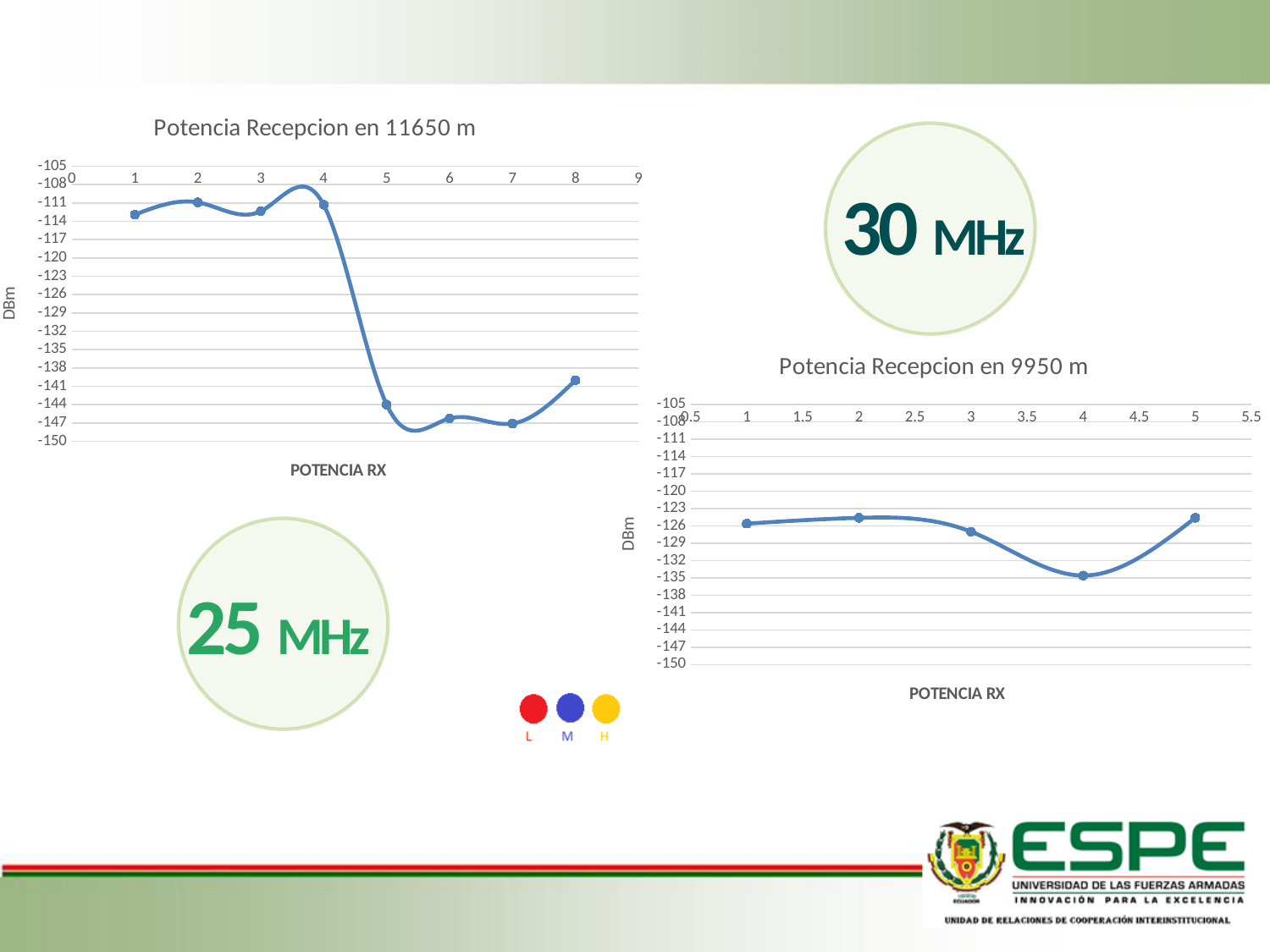
What kind of chart is 'Potencia Recepcion en 9950 m'? line chart In the 'Potencia Recepcion en 11650 m' chart, which is larger, the value at x = 2 or the value at x = 6? x = 2 What kind of chart is 'Potencia Recepcion en 11650 m'? line chart How many data points are plotted in the 'Potencia Recepcion en 11650 m' chart? 8 What is the y-axis label of the 'Potencia Recepcion en 11650 m' chart? DBm What series name is shown in the legend of the 'Potencia Recepcion en 9950 m' chart? POTENCIA RX In the 'Potencia Recepcion en 9950 m' chart, is the value at x = 4 greater or less than -132? less In the 'Potencia Recepcion en 11650 m' chart, is the value at x = 5 greater or less than -120? less In the 'Potencia Recepcion en 11650 m' chart, is the value at x = 1 greater or less than -120? greater In the 'Potencia Recepcion en 11650 m' chart, does the value rise or fall between x = 4 and x = 5? fall How many data points are plotted in the 'Potencia Recepcion en 9950 m' chart? 5 In the 'Potencia Recepcion en 9950 m' chart, at which x value is the plotted value lowest? 4